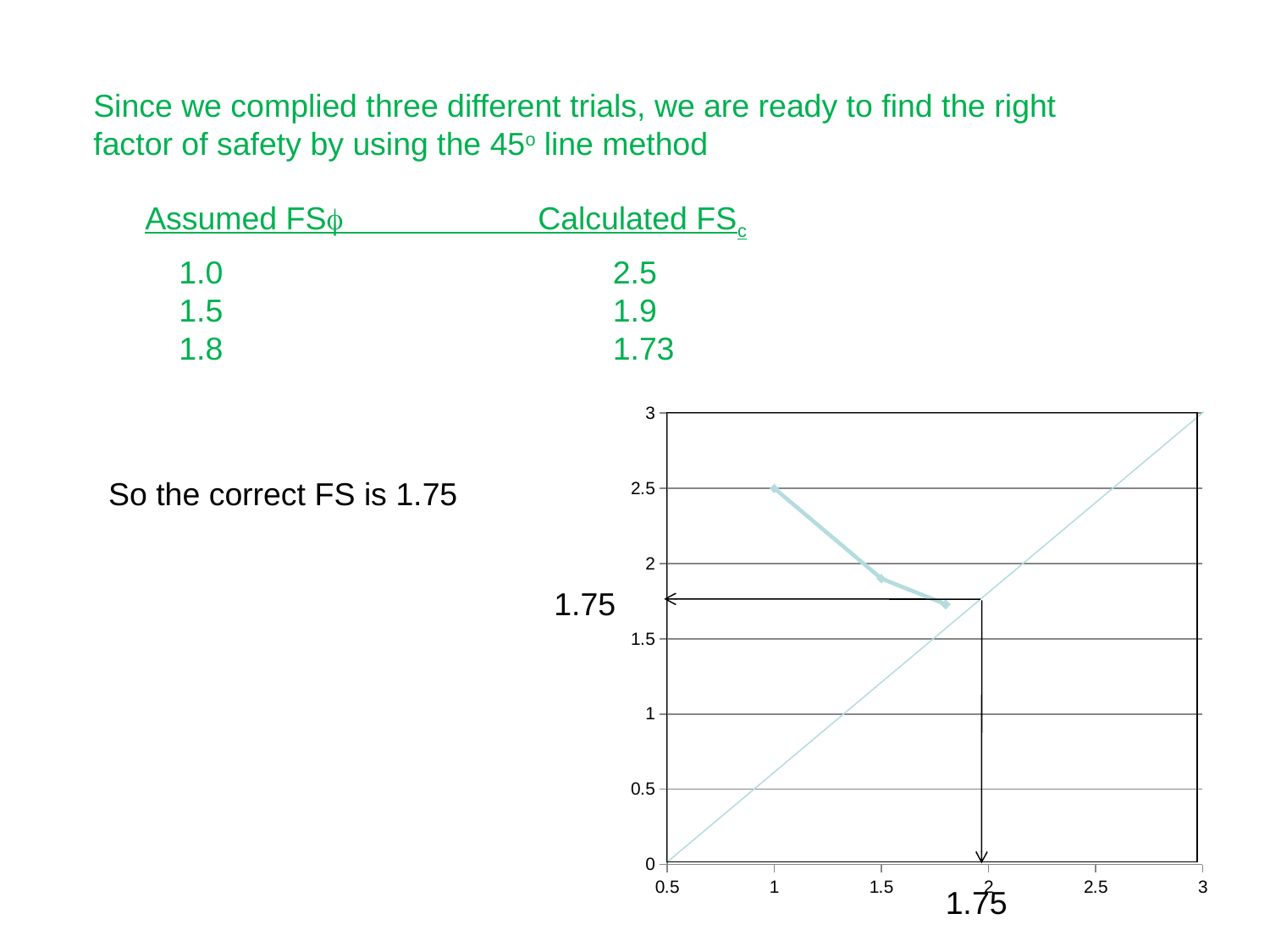
How many data points are plotted on the curve of calculated FS versus assumed FS? 3 What is the calculated FS when the assumed FS is 1.8? 1.73 What is the calculated FS when the assumed FS is 1.0? 2.5 Which assumed FS gives the lowest calculated FS? 1.8 What is the calculated FS when the assumed FS is 1.5? 1.9 Do the plotted calculated FS values rise or fall as the assumed FS increases along the x axis? fall What kind of chart is shown on the slide? line chart What value is marked by the arrows where the curve meets the 45° line on the chart? 1.75 Which assumed FS gives the highest calculated FS? 1.0 What is the difference between the calculated FS at assumed FS 1.0 and at assumed FS 1.5? 0.6 Is the calculated FS larger at assumed FS 1.0 or at assumed FS 1.8? 1.0 Is the calculated FS at assumed FS 1.5 greater or less than 2? less